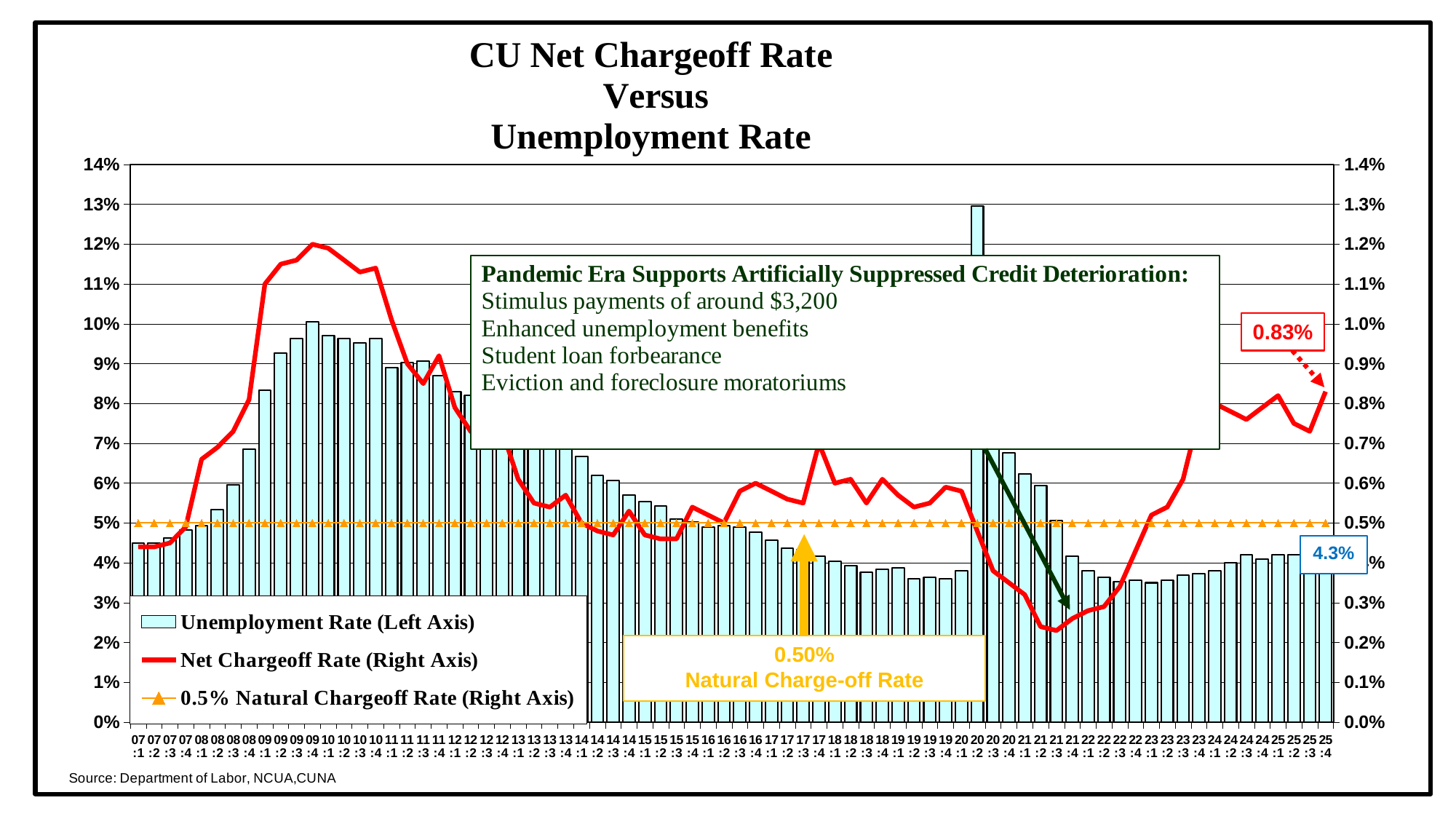
Is the Net Chargeoff Rate at 25:4 (0.83%) higher or lower than the 0.50% Natural Charge-off Rate? higher What is the Net Chargeoff Rate labelled at the end of the series (25:4)? 0.83% Does the Unemployment Rate rise or fall from 10:1 to 19:4? fall On which axis is the Unemployment Rate plotted? Left axis Is the Net Chargeoff Rate for 21:2 greater or less than 0.3%? less Which quarter has the highest Unemployment Rate? 20:2 What kind of chart is shown on the slide? A combination bar and line chart How many series does the legend list? 3 What value is the Natural Charge-off Rate line set at? 0.50% Is the Unemployment Rate for 20:2 greater or less than 12%? greater What is the Unemployment Rate labelled at the end of the series (25:4)? 4.3% Is the Net Chargeoff Rate for 09:4 greater or less than 1.0%? greater